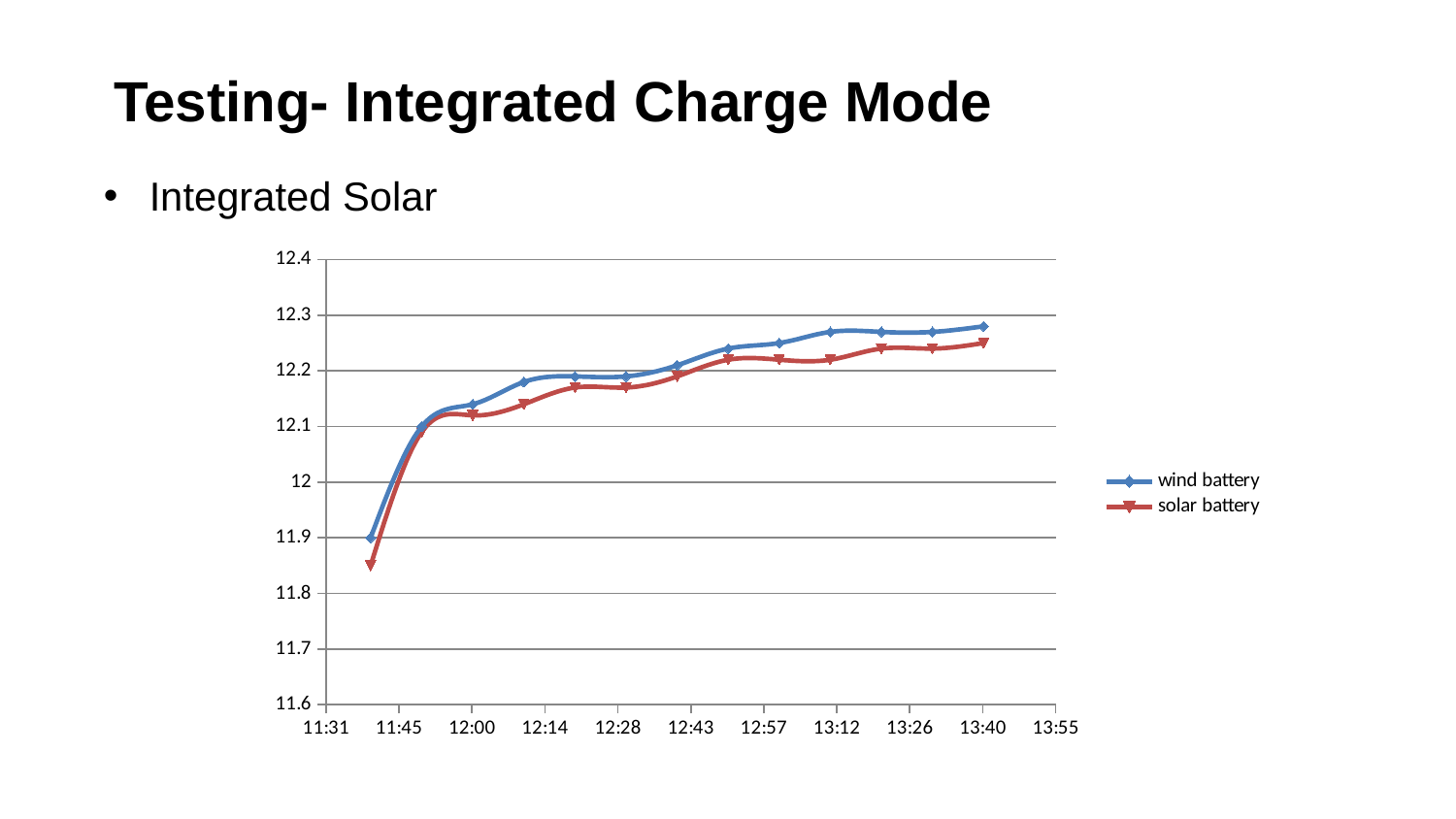
Do the battery values generally rise or fall over time along the x axis? rise Is the wind battery value at 12:00 greater or less than 12.1? greater Is the wind battery value at 13:40 greater or less than 12.2? greater At 13:40, which series has the higher value, wind battery or solar battery? wind battery Is the solar battery value at 12:28 greater or less than 12.2? less What are the two series named in the legend? wind battery and solar battery How many data points are plotted for the wind battery series? 13 Which series reaches the highest value on the chart? wind battery What kind of chart is shown on the slide? line chart What colour is the wind battery line? blue How many series does the legend list? 2